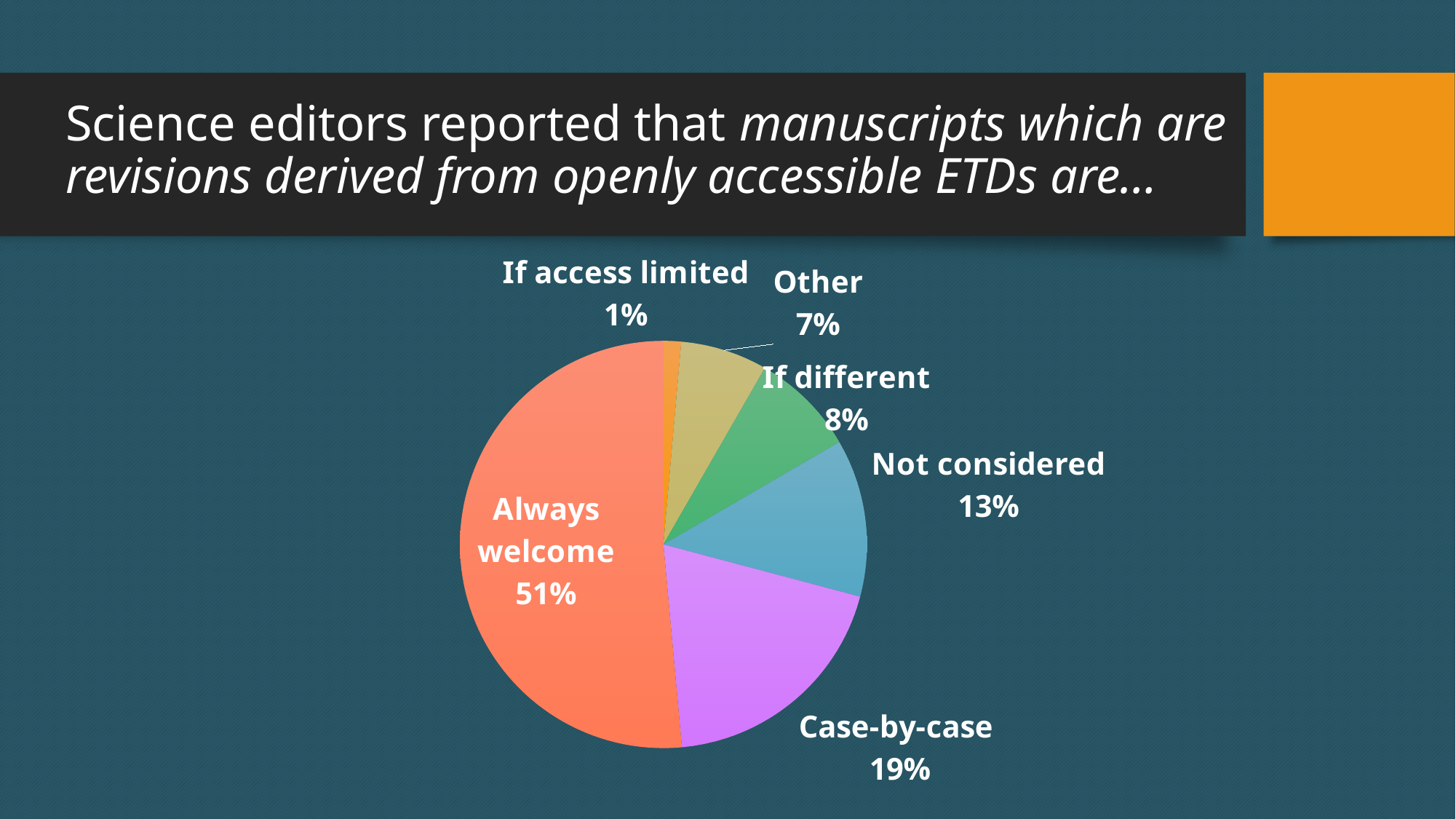
How many slices does the pie chart have? 6 Which slice of the pie is the smallest? If access limited Which slice of the pie is the largest? Always welcome What share of the pie is labelled "Always welcome"? 51% What is the difference in percentage points between "Always welcome" and "Case-by-case"? 32 What kind of chart is shown on the slide? Pie chart What percentage is shown for "Case-by-case"? 19% What colour is the "Always welcome" slice? Orange-red (coral) Which is larger, "Not considered" or "Other"? Not considered What percentage is shown for "If different"? 8% What percentage is shown for "If access limited"? 1% What percentage is shown for "Not considered"? 13%